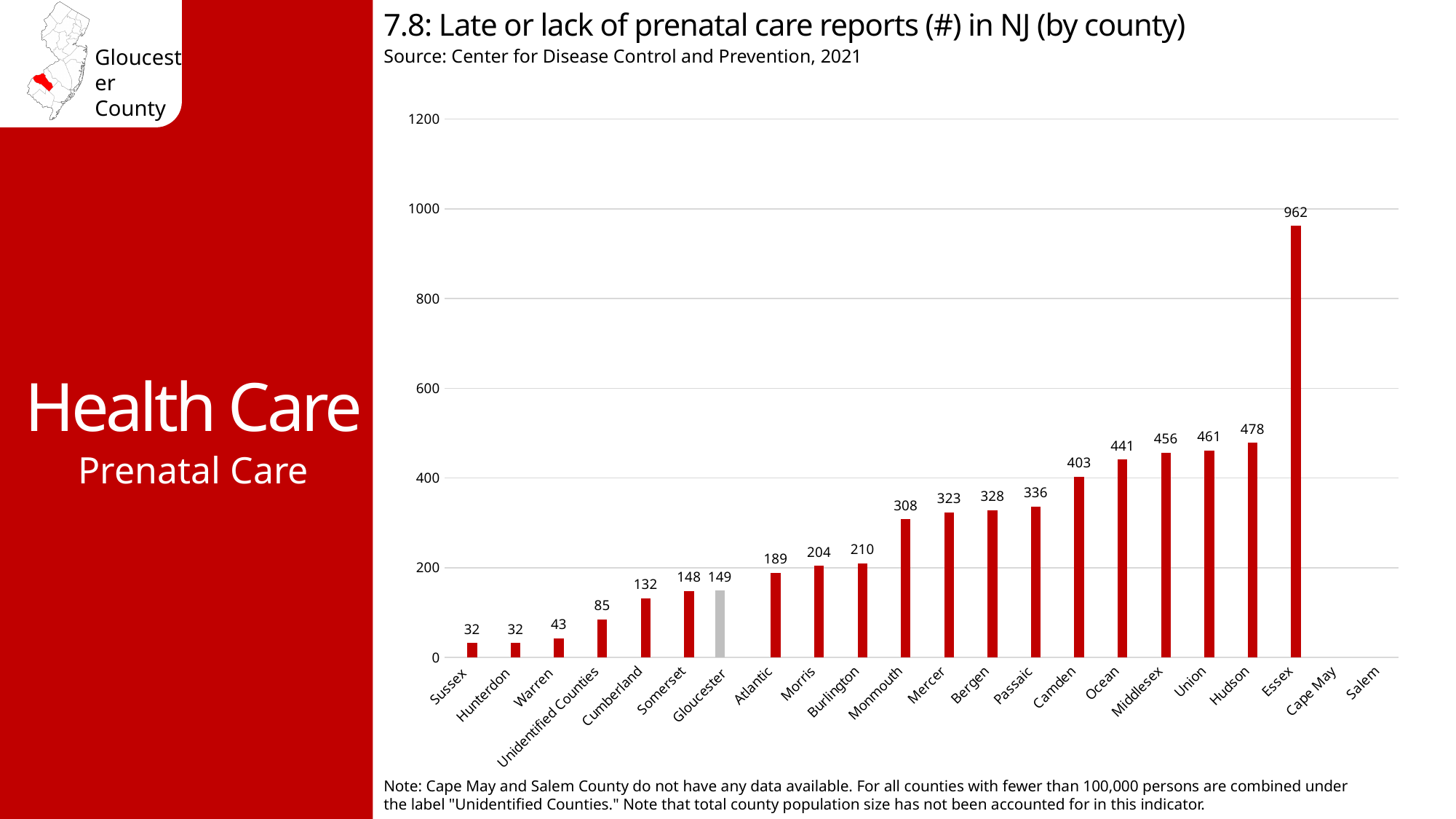
Which two counties share the lowest plotted value? Sussex and Hunterdon Which county has the highest number of late or lack of prenatal care reports? Essex What is the value for Gloucester? 149 What is the value for Monmouth? 308 What kind of chart is shown on the slide? Bar chart Which county's bar is coloured grey instead of red? Gloucester Do the plotted values rise or fall from Sussex to Essex along the x axis? Rise What is the difference between the values for Gloucester and Somerset? 1 What is the value for Essex? 962 What is the difference between the values for Essex and Hudson? 484 How many categories are listed along the x axis? 22 Which is larger, the value for Camden or the value for Passaic? Camden